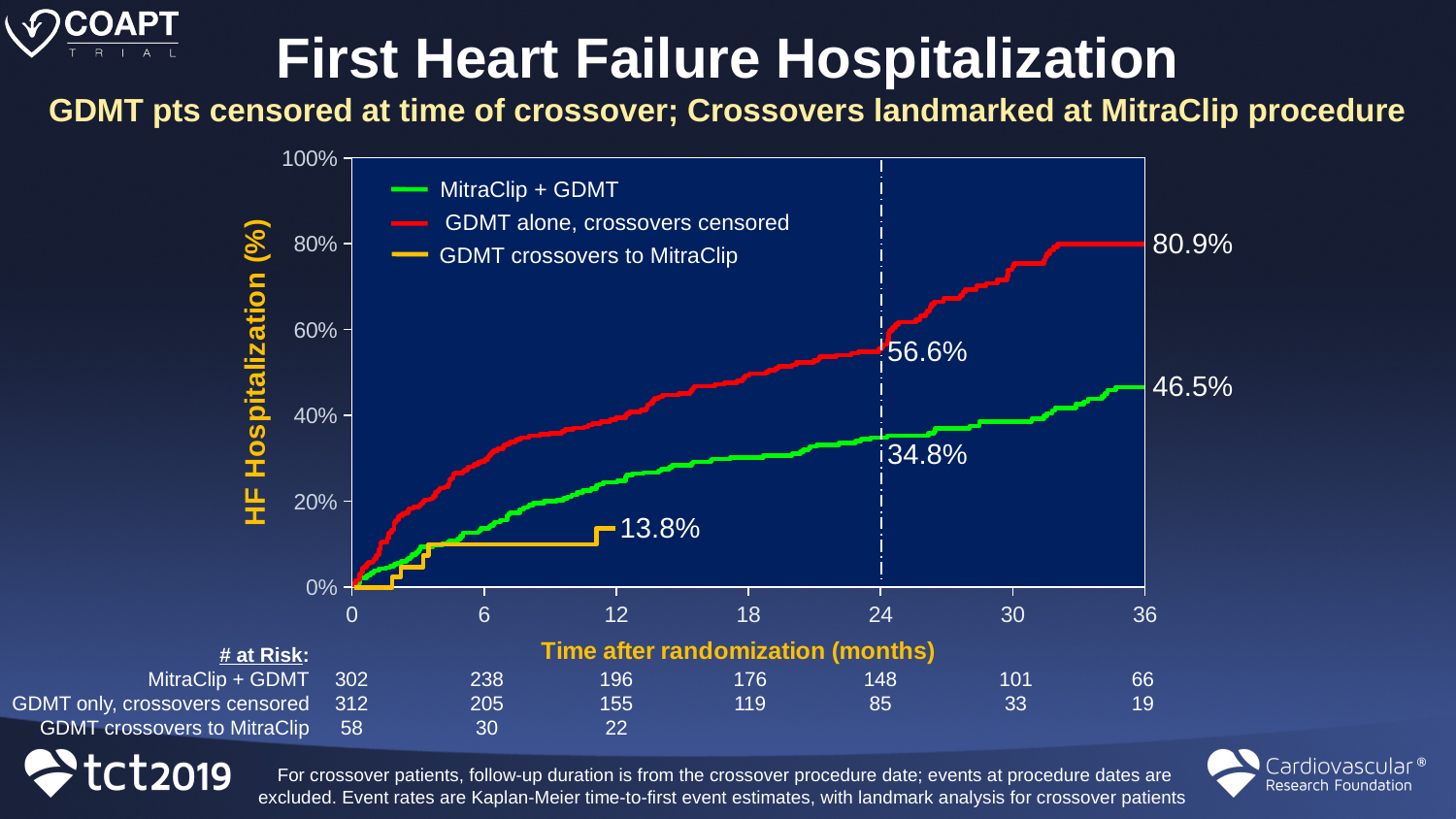
Is the HF hospitalization rate for the MitraClip + GDMT group at 6 months greater or less than 20%? less What is the difference in HF hospitalization rate between the GDMT alone, crossovers censored group and the MitraClip + GDMT group at 36 months? 34.4 percentage points What is the HF hospitalization rate for the GDMT alone, crossovers censored group at 24 months? 56.6% How many MitraClip + GDMT patients were at risk at 24 months? 148 Which group has the higher HF hospitalization rate at 24 months, MitraClip + GDMT or GDMT alone, crossovers censored? GDMT alone, crossovers censored What is the HF hospitalization rate for the GDMT alone, crossovers censored group at 36 months? 80.9% What is the HF hospitalization rate for the MitraClip + GDMT group at 24 months? 34.8% Do the HF hospitalization curves rise or fall as time after randomization increases? Rise What is the HF hospitalization rate for the MitraClip + GDMT group at 36 months? 46.5% What kind of chart is shown on the slide? Line chart (Kaplan-Meier curve) How many series does the legend list? 3 What is the HF hospitalization rate labeled for the GDMT crossovers to MitraClip curve? 13.8%